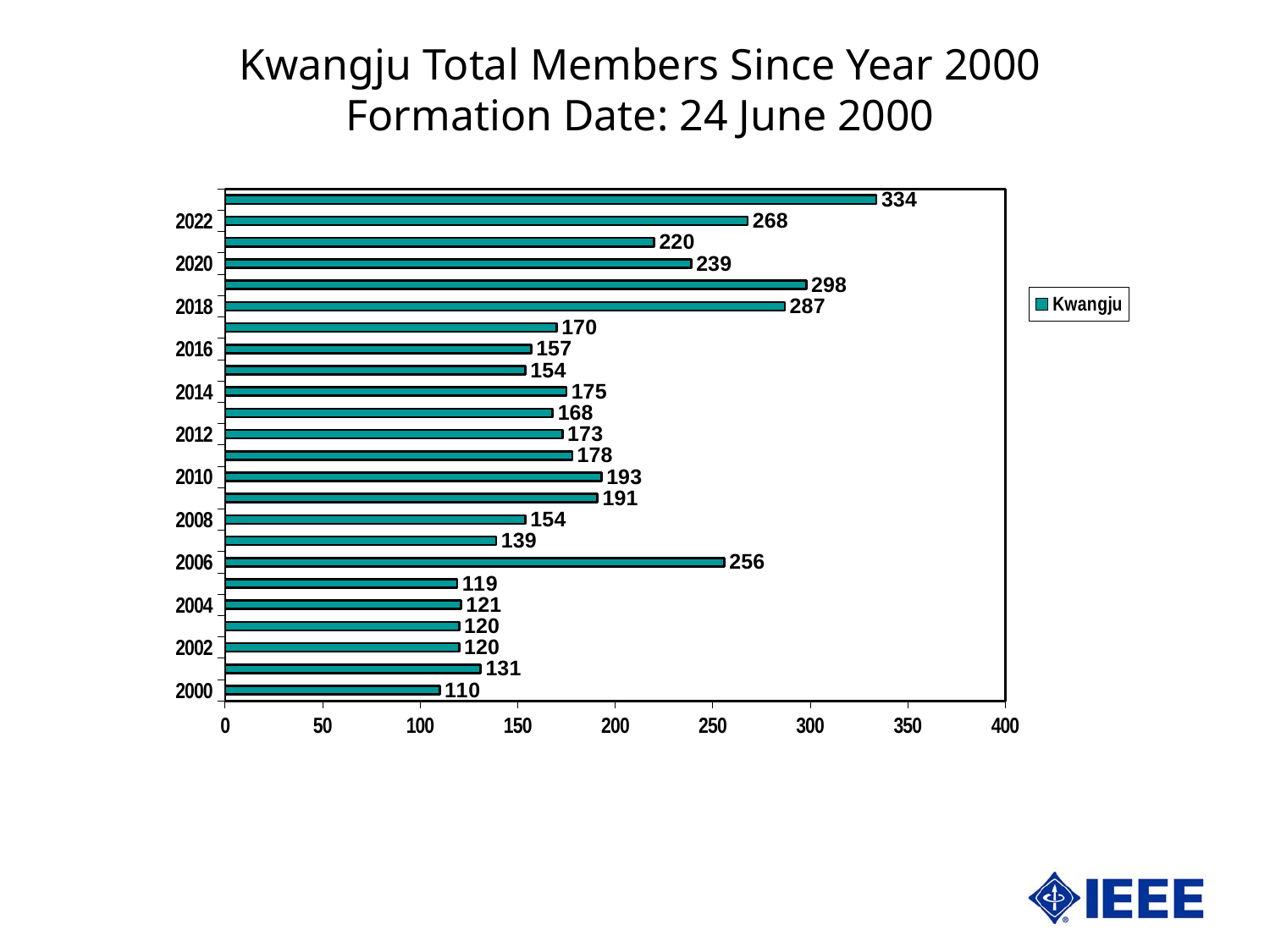
Which is larger, the value for 2010 or the value for 2016? 2010 What is the value for 2000? 110 Is the value for 2014 greater or less than 150? greater What is the value for 2018? 287 Which year has the lowest value? 2000 What kind of chart is shown on the slide? bar chart What is the difference between the values for 2022 and 2020? 29 What is the value for 2006? 256 What is the value of the longest bar in the chart? 334 What series name does the legend show? Kwangju How many bars are plotted in the chart? 24 What is the value for 2022? 268